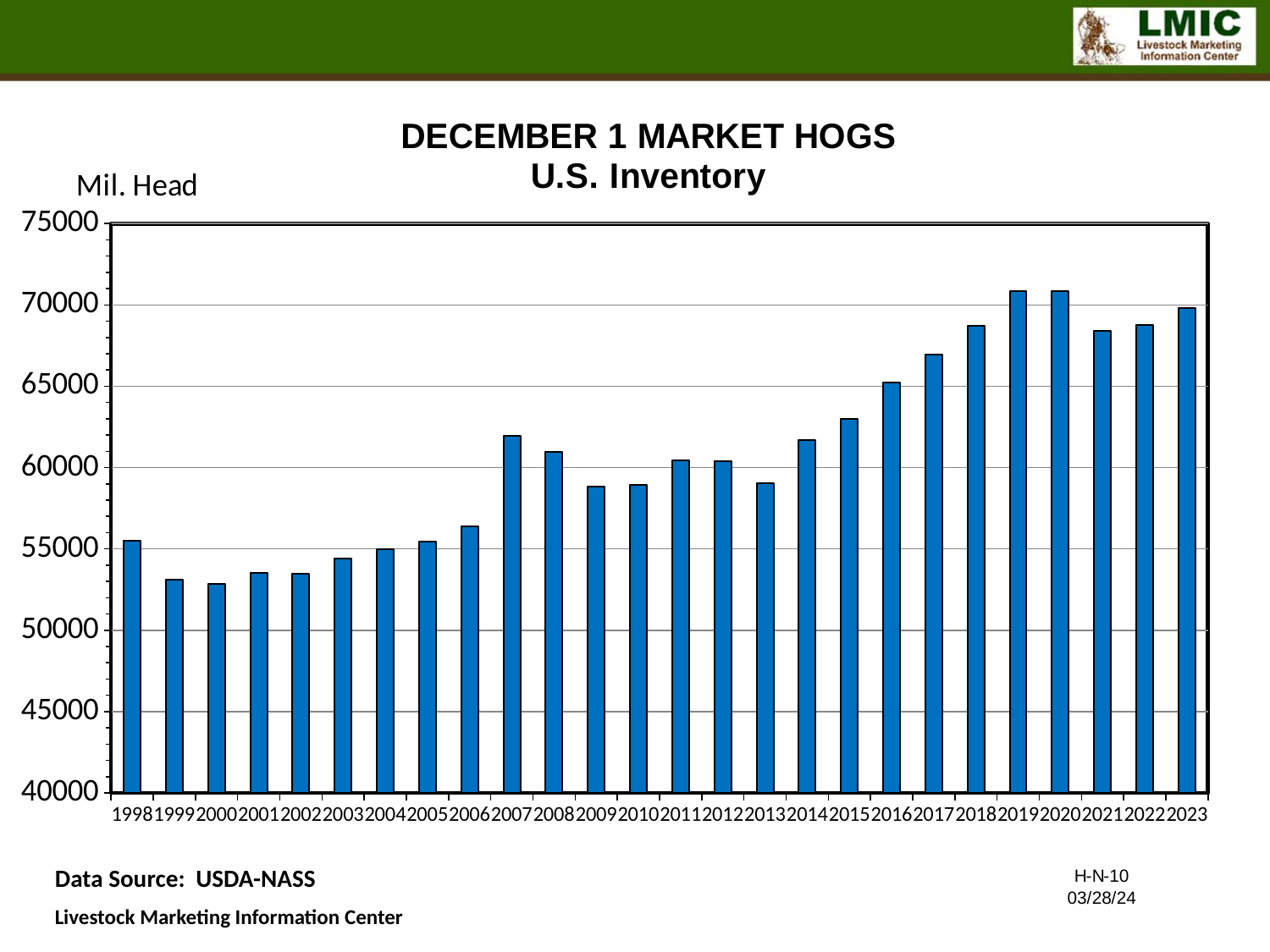
Is the value for 2009 greater or less than 60000? less Which year has the larger value, 2007 or 2008? 2007 Is the value for 2021 greater or less than 70000? less Which year has the larger value, 1998 or 1999? 1998 What is the title of the chart? DECEMBER 1 MARKET HOGS U.S. Inventory How many years (bars) are plotted on the chart? 26 Is the value for 2007 greater or less than 60000? greater What kind of chart is shown on the slide? bar chart Do the values rise or fall from 2013 to 2019? rise What unit label is shown on the vertical axis? Mil. Head